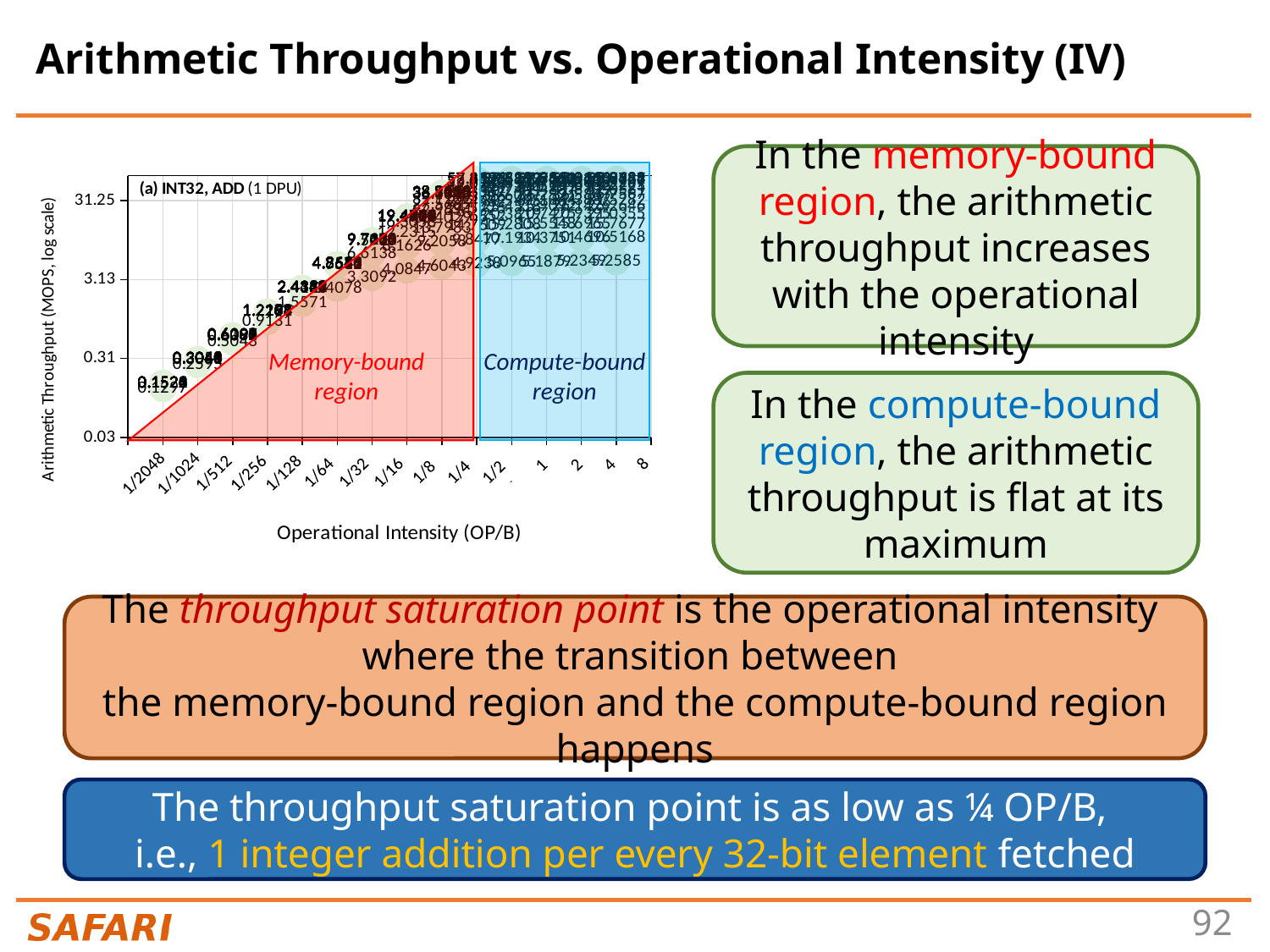
Is the arithmetic throughput at operational intensity 1/256 greater or less than 0.31? greater Which has the higher arithmetic throughput: operational intensity 1/1024 or operational intensity 1/32? 1/32 How many tick labels are shown on the x axis of the chart? 15 What is the title of the y axis of the chart? Arithmetic Throughput (MOPS, log scale) What are the names of the two shaded regions in the chart? Memory-bound region and Compute-bound region What is the lowest tick value shown on the y axis of the chart? 0.03 Does the arithmetic throughput rise or fall as operational intensity increases from 1/2048 to 1/4? rise In which region of the chart is the arithmetic throughput flat at its maximum? Compute-bound region Is the arithmetic throughput at operational intensity 1/256 greater or less than 3.13? less Is the arithmetic throughput at operational intensity 1/16 greater or less than 3.13? greater